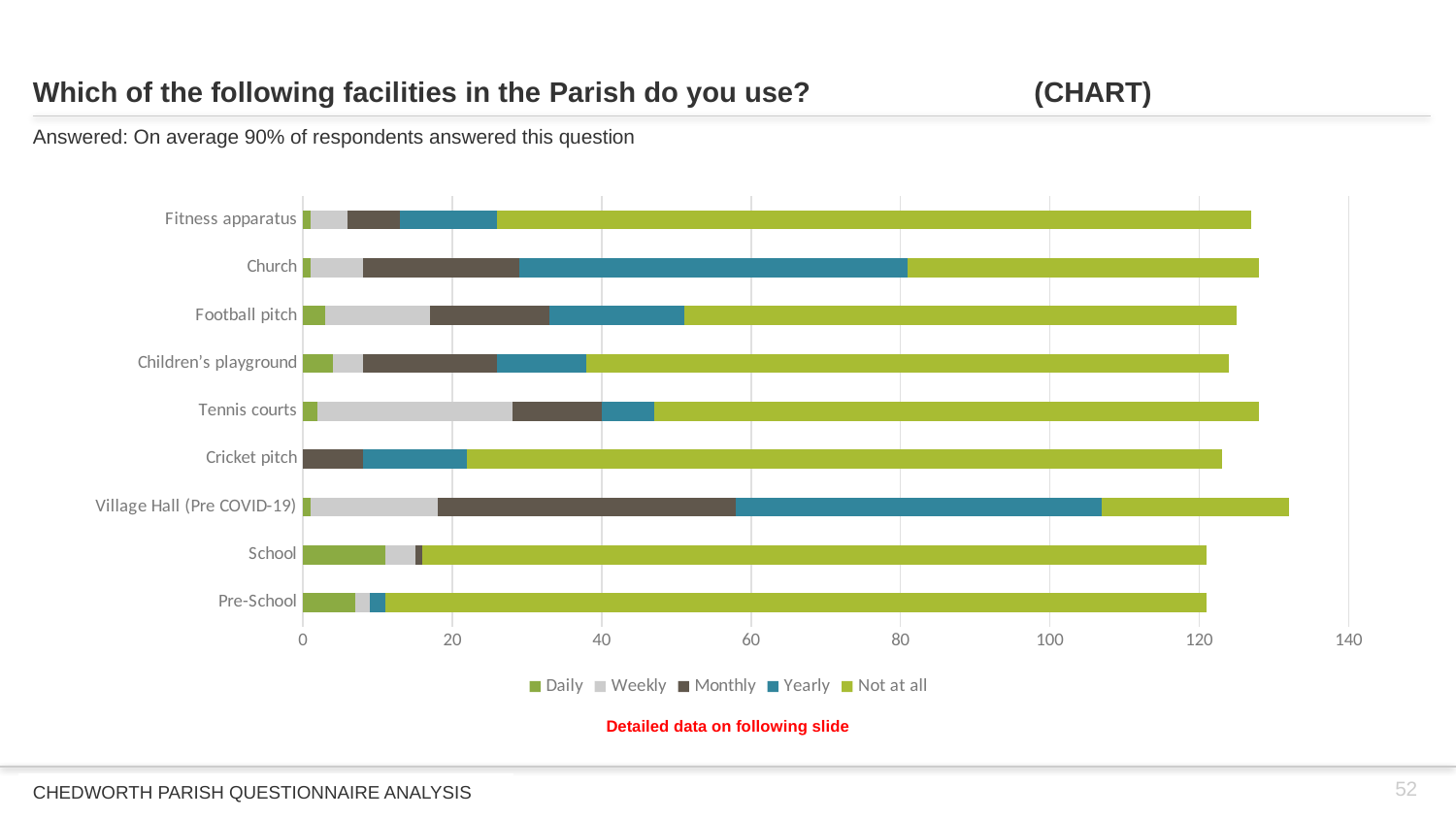
Is the total bar length for Church greater or less than 100? greater Is the 'Not at all' segment larger for Cricket pitch or for Village Hall (Pre COVID-19)? Cricket pitch Which series does the legend list last? Not at all Is the Yearly segment larger for Church or for Fitness apparatus? Church Which facility has the largest Daily segment? School Which facility has the largest Monthly segment? Village Hall (Pre COVID-19) What kind of chart is shown on the slide? Stacked bar chart Which facility has the smallest 'Not at all' segment? Village Hall (Pre COVID-19) Which facility has the largest Weekly segment? Tennis courts How many facilities (categories) are listed on the chart? 9 How many series does the legend list? 5 Is the total bar length for Village Hall (Pre COVID-19) greater or less than 120? greater